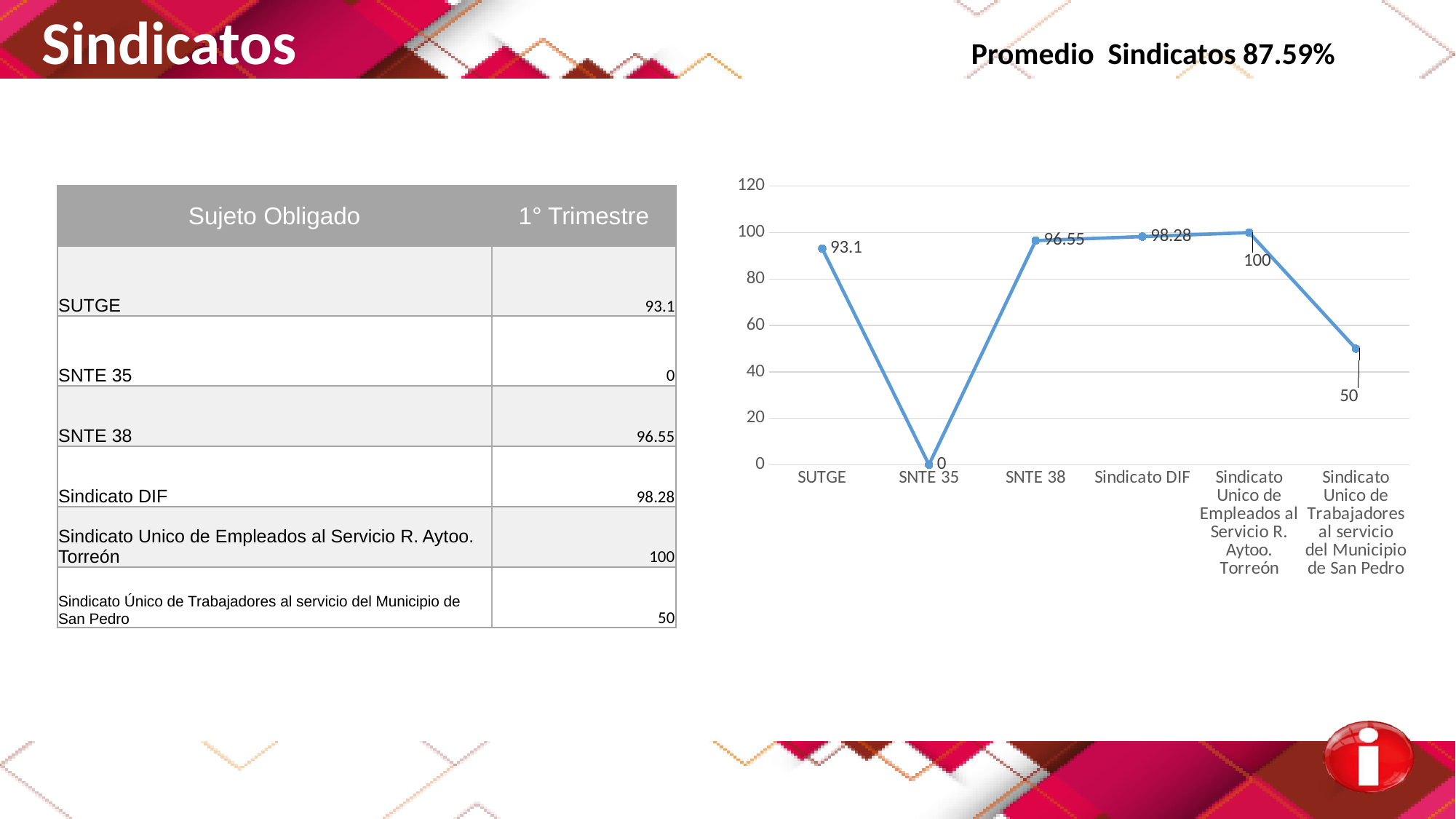
Is the value for Sindicato Unico de Trabajadores al servicio del Municipio de San Pedro greater or less than 80? less Which is larger, the value for SUTGE or the value for SNTE 38? SNTE 38 What is the value for SNTE 38? 96.55 Which category has the lowest value? SNTE 35 What is the value for SUTGE? 93.1 What is the value for Sindicato Unico de Trabajadores al servicio del Municipio de San Pedro? 50 How many categories are plotted on the x axis? 6 What is the maximum value shown on the vertical axis? 120 Which category has the highest value? Sindicato Unico de Empleados al Servicio R. Aytoo. Torreón What is the difference between the values for Sindicato DIF and SNTE 38? 1.73 What is the value for Sindicato DIF? 98.28 What kind of chart is shown on the slide? line chart